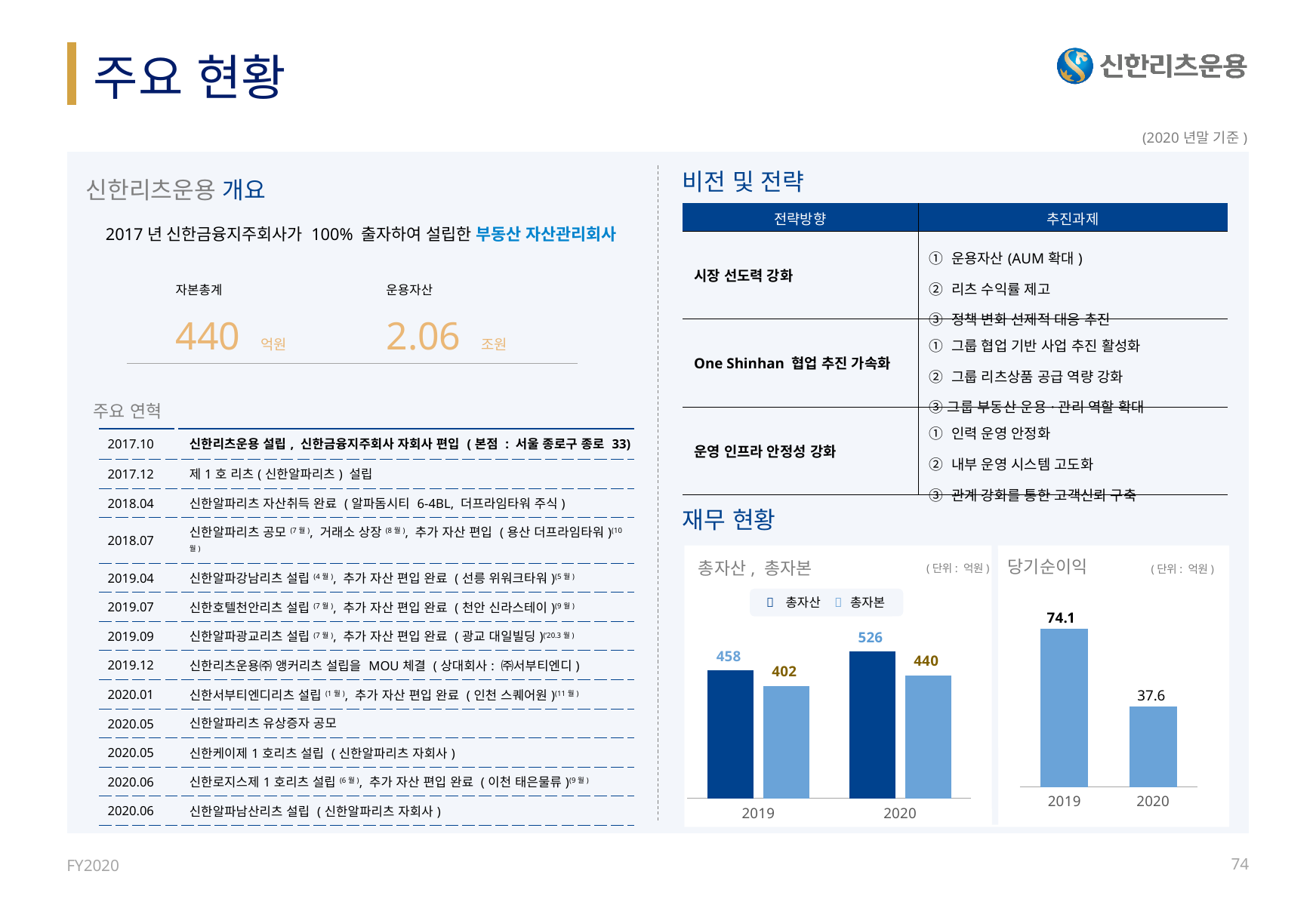
In the '당기순이익' chart, what is the difference between the 2019 and 2020 values? 36.5 In the '당기순이익' chart, which year has the lower value? 2020 What kind of chart is the '당기순이익' chart? bar chart In the '당기순이익' chart, what is the value for 2019? 74.1 In the '총자산, 총자본' chart, what is the value of 총자본 for 2019? 402 In the '총자산, 총자본' chart, by how much did 총자산 increase from 2019 to 2020? 68 In the '총자산, 총자본' chart, how many series does the legend list? 2 In the '당기순이익' chart, what is the value for 2020? 37.6 In the '총자산, 총자본' chart, what is the difference between 총자산 and 총자본 in 2020? 86 What unit is shown for the '당기순이익' chart? 억원 In the '총자산, 총자본' chart, does 총자본 rise or fall from 2019 to 2020? rise In the '총자산, 총자본' chart, what is the value of 총자산 for 2020? 526